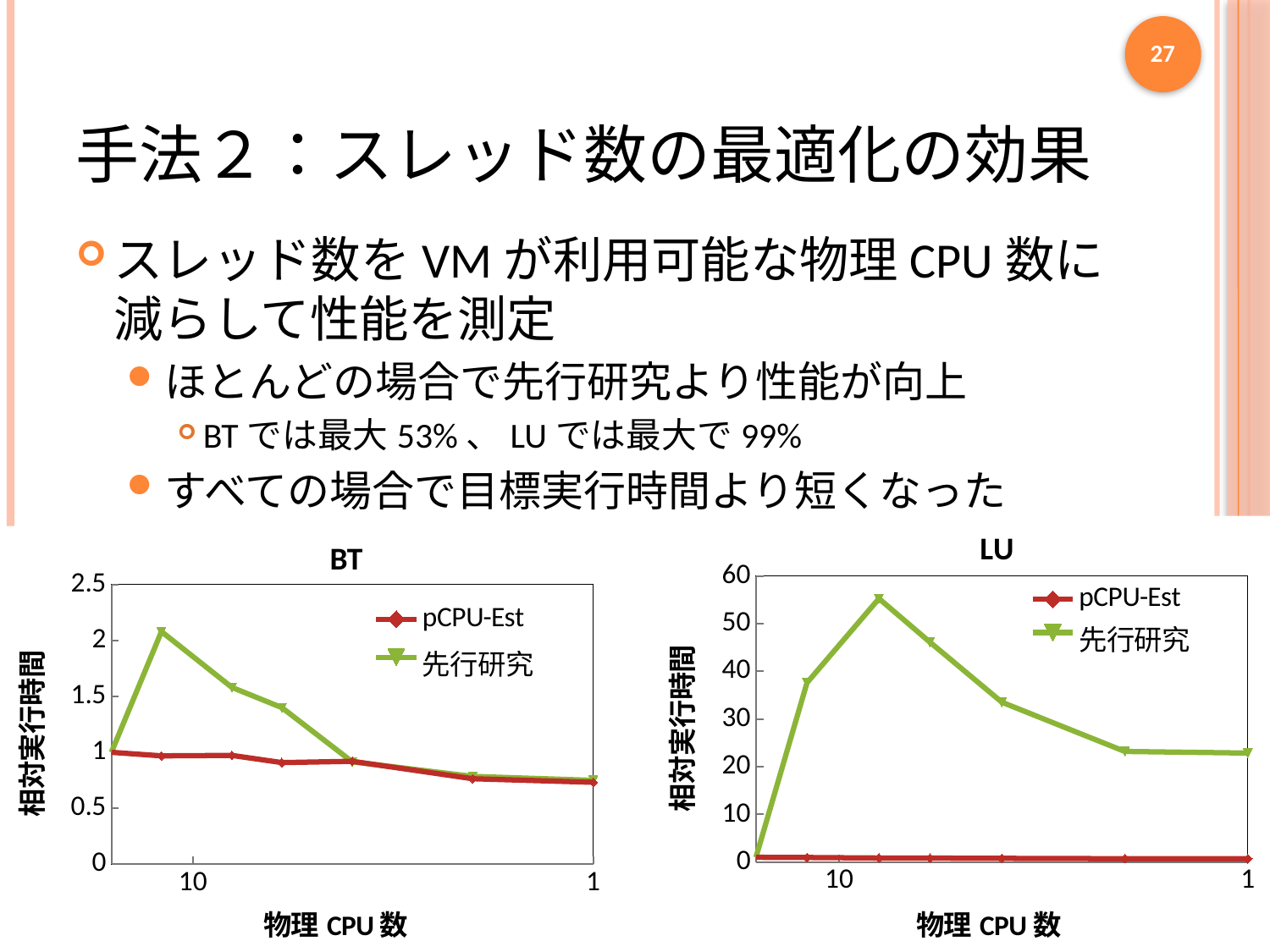
What are the two series named in the legend of the BT chart? pCPU-Est and 先行研究 What is the highest tick value shown on the y axis of the LU chart? 60 In the LU chart, which series has the lower values across the x axis, pCPU-Est or 先行研究? pCPU-Est In the LU chart, after its peak, does the 先行研究 series rise or fall as the number of physical CPUs decreases toward 1? fall In the BT chart, which series reaches the higher peak value, pCPU-Est or 先行研究? 先行研究 In the BT chart, are all values of the pCPU-Est series greater or less than 1.5? less How many series does the legend of the LU chart list? 2 What is the y-axis label of the LU chart? 相対実行時間 In the BT chart, is the highest value of the 先行研究 series greater or less than 1.5? greater In the LU chart, is the highest value of the 先行研究 series greater or less than 50? greater What kind of chart is the BT chart? line chart